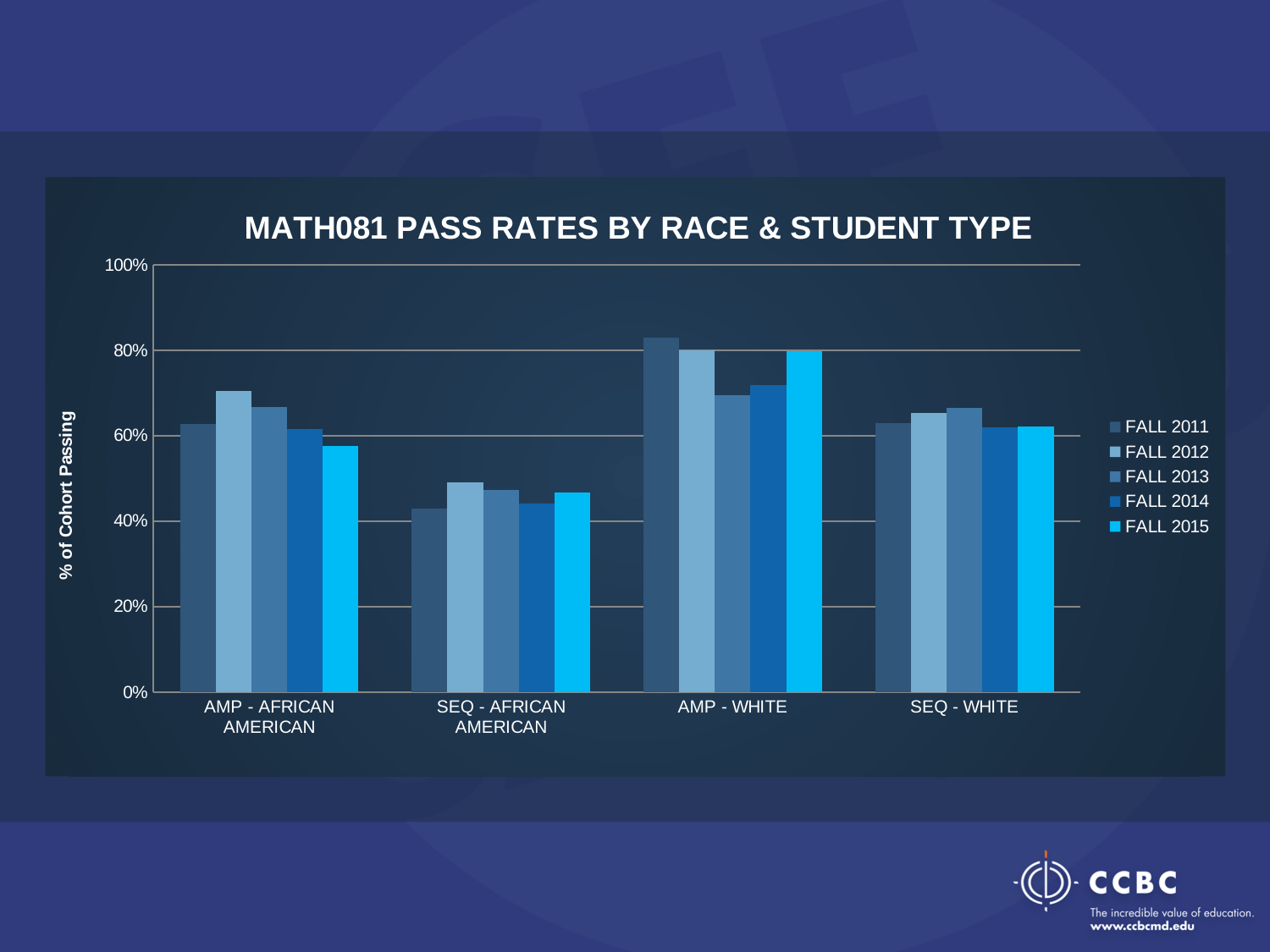
Is the value for SEQ - AFRICAN AMERICAN in FALL 2011 greater or less than 60%? less Which category has the highest FALL 2011 pass rate? AMP - WHITE What kind of chart is shown on the slide? Bar chart Is the value for AMP - AFRICAN AMERICAN in FALL 2015 greater or less than 60%? less For AMP - AFRICAN AMERICAN, do the values rise or fall from FALL 2012 to FALL 2015? fall For AMP - AFRICAN AMERICAN, which is larger: the FALL 2012 value or the FALL 2015 value? FALL 2012 Is the value for AMP - WHITE in FALL 2011 greater or less than 80%? greater How many categories are shown on the x axis? 4 For FALL 2013, which is larger: SEQ - WHITE or SEQ - AFRICAN AMERICAN? SEQ - WHITE What is the title of the vertical axis? % of Cohort Passing Which category has the lowest FALL 2012 pass rate? SEQ - AFRICAN AMERICAN How many series does the legend list? 5